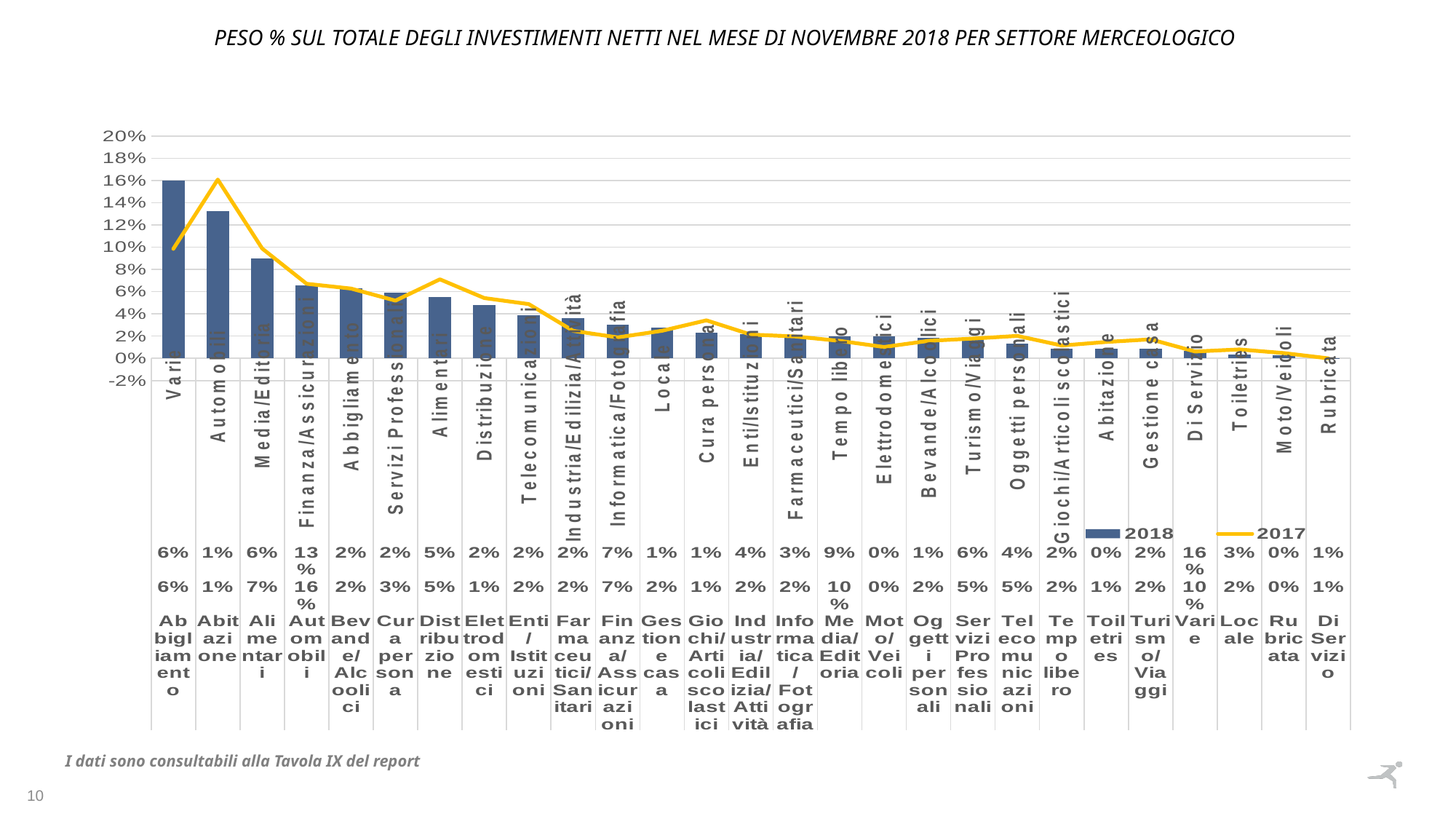
Do the 2018 bars rise or fall from left to right along the x axis? Fall What kind of chart is this? Bar chart with a line series How many categories are shown on the x axis? 27 Which category has the highest 2018 value? Varie What is the 2018 value for Varie? 16% What is the difference between the 2018 and 2017 values for Varie? 6 percentage points What is the 2017 value for Automobili? 16% Which category has the highest 2017 value? Automobili What is the 2017 value for Alimentari? 7% What is the 2018 value for Media/Editoria? 9% Which is larger, the 2018 value for Automobili or the 2018 value for Media/Editoria? Automobili How many series does the legend list? 2